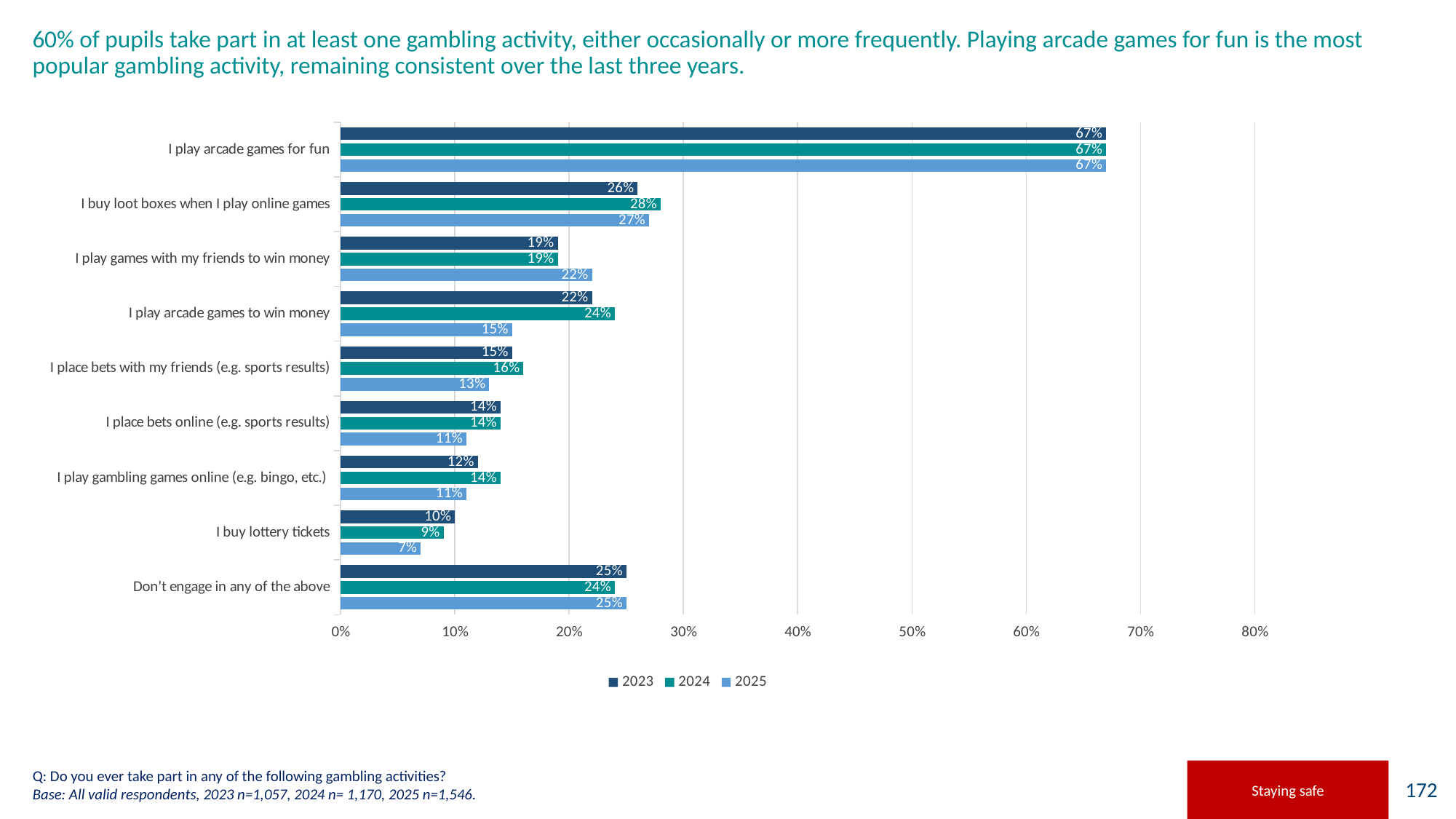
What is the difference between the 2024 and 2025 values for "I play arcade games to win money"? 9% Which is larger for "I play games with my friends to win money": the 2023 value or the 2025 value? 2025 Which activity has the lowest value in 2024? I buy lottery tickets What is the 2023 value for "I buy lottery tickets"? 10% How many series does the legend list? 3 Is the 2023 value for "Don't engage in any of the above" greater or less than 20%? greater What is the 2025 value for "I buy loot boxes when I play online games"? 27% Which years are listed in the legend? 2023, 2024, 2025 Which activity has the highest value in 2025? I play arcade games for fun What kind of chart is shown on the slide? Bar chart How many activity categories are shown on the chart? 9 What is the 2024 value for "I play arcade games to win money"? 24%